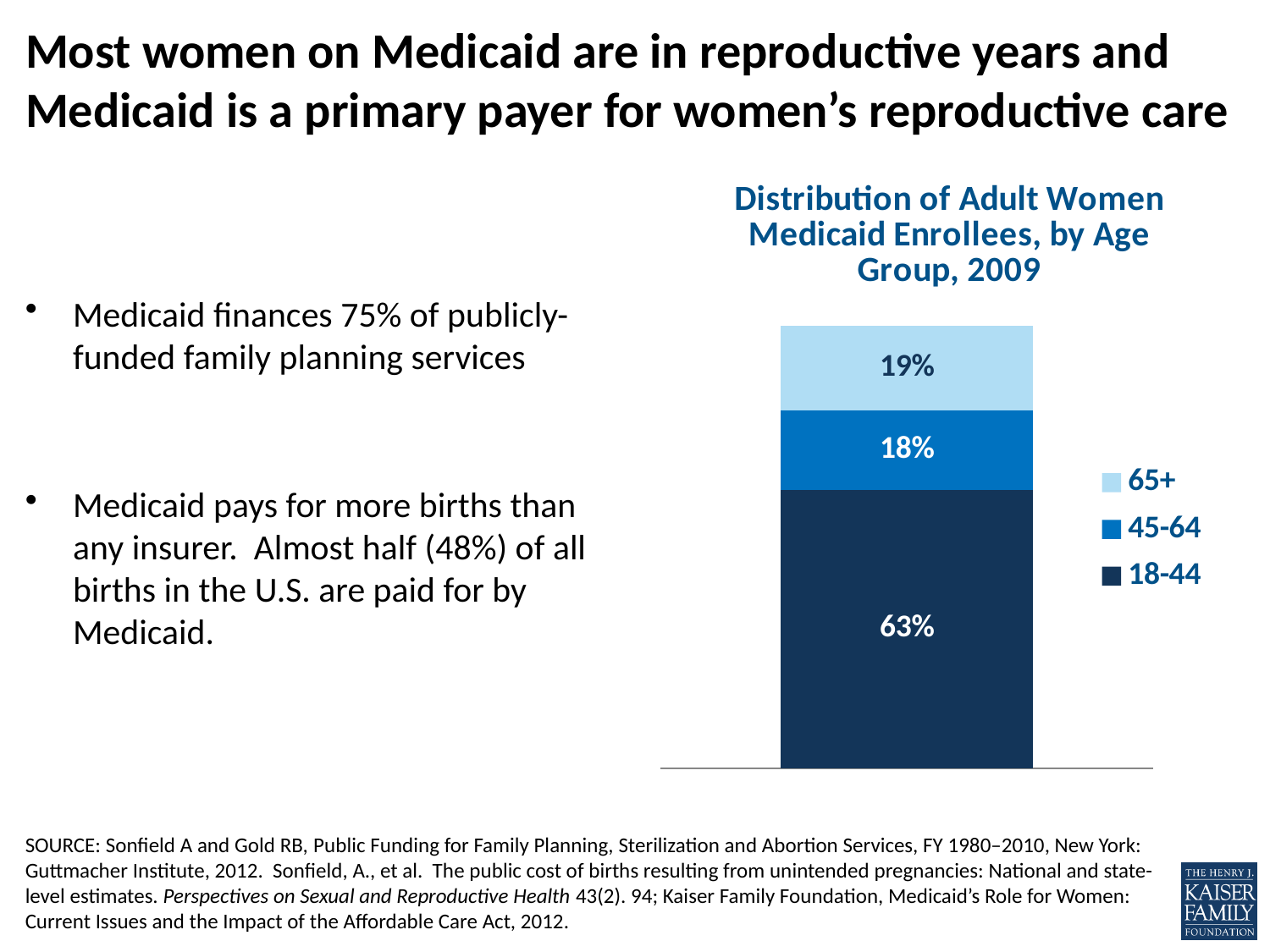
How many age groups does the legend list? 3 What is the total of the three segments in the stacked bar? 100% Which age group makes up the smallest share of adult women Medicaid enrollees? 45-64 What is the difference in percentage points between the 65+ share and the 45-64 share? 1 What is the difference in percentage points between the 18-44 share and the 65+ share? 44 What is the title of the chart? Distribution of Adult Women Medicaid Enrollees, by Age Group, 2009 What share of adult women Medicaid enrollees are aged 45-64? 18% What kind of chart is shown on the slide? Stacked bar chart What share of adult women Medicaid enrollees are aged 18-44? 63% Which is larger, the share for 18-44 or the share for 45-64? 18-44 Which age group makes up the largest share of adult women Medicaid enrollees? 18-44 What share of adult women Medicaid enrollees are aged 65+? 19%